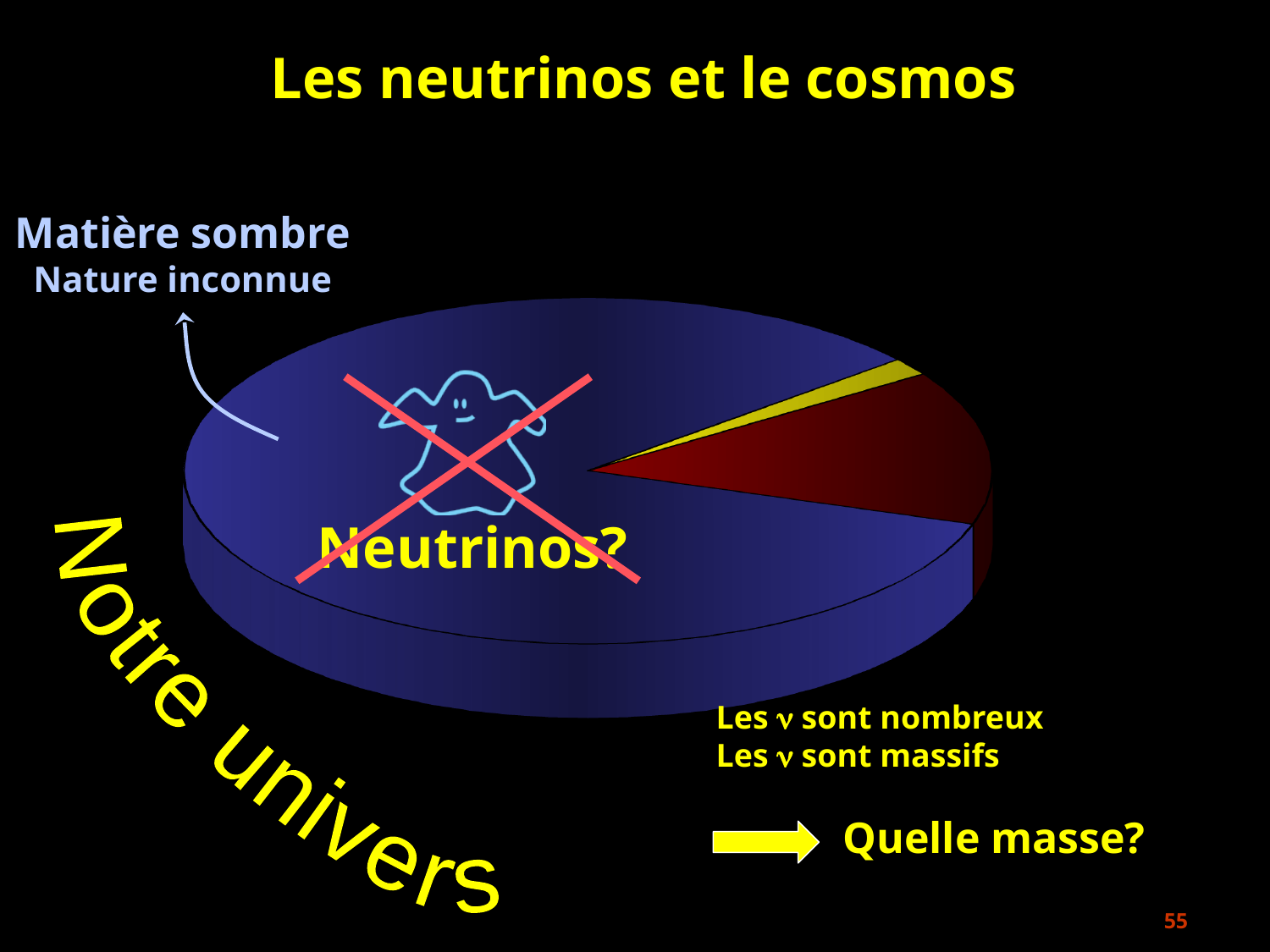
Which slice of the pie chart is the largest? Matière sombre (the blue slice) Which colour slice of the pie chart is the smallest? yellow Does the blue slice take up more or less than half of the pie? more Which is larger in the pie chart, the red slice or the yellow slice? the red slice What kind of chart is shown on the slide? pie chart Which is larger in the pie chart, the blue slice or the red slice? the blue slice What is the title of the slide containing the pie chart? Les neutrinos et le cosmos What label does the arrow pointing to the largest slice of the pie chart carry? Matière sombre How many slices does the pie chart have? 3